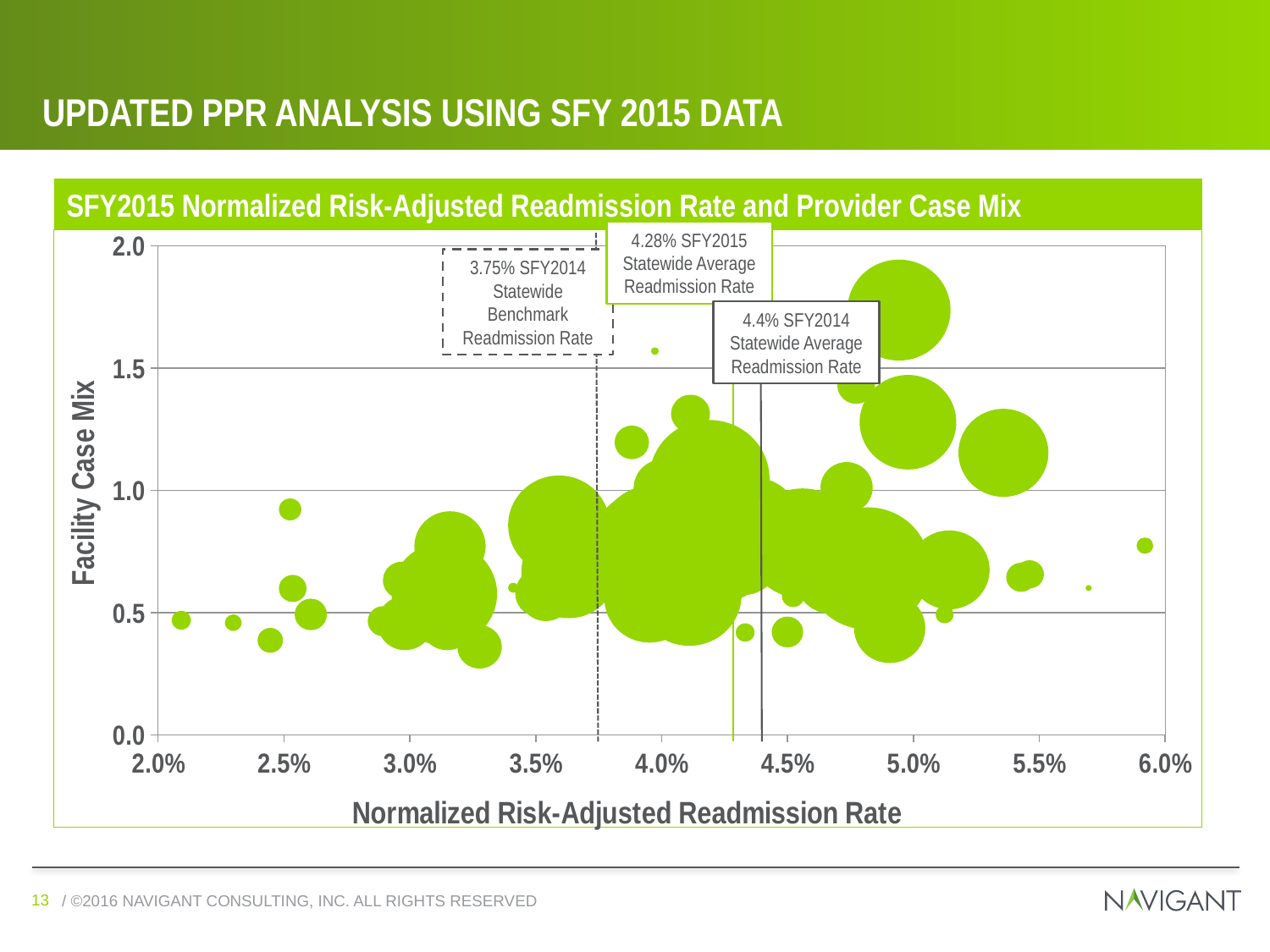
What is the SFY2015 Statewide Average Readmission Rate marked on the chart? 4.28% Is the Facility Case Mix of the largest bubble greater or less than 1.5? greater What is the SFY2014 Statewide Benchmark Readmission Rate marked on the chart? 3.75% Is the Normalized Risk-Adjusted Readmission Rate of the leftmost bubble greater or less than 2.5%? less What is the SFY2014 Statewide Average Readmission Rate marked on the chart? 4.4% What is the title of the chart? SFY2015 Normalized Risk-Adjusted Readmission Rate and Provider Case Mix What kind of chart is shown on the slide? Bubble chart Which of the three marked reference rates is the lowest? 3.75% SFY2014 Statewide Benchmark Readmission Rate Which is higher, the SFY2014 Statewide Average Readmission Rate or the SFY2015 Statewide Average Readmission Rate? SFY2014 Statewide Average Readmission Rate What is the label of the x axis? Normalized Risk-Adjusted Readmission Rate Is the Facility Case Mix of the rightmost bubble (near 6.0%) greater or less than 1.0? less By how many percentage points does the SFY2014 Statewide Average Readmission Rate (4.4%) exceed the SFY2015 Statewide Average Readmission Rate (4.28%)? 0.12 percentage points